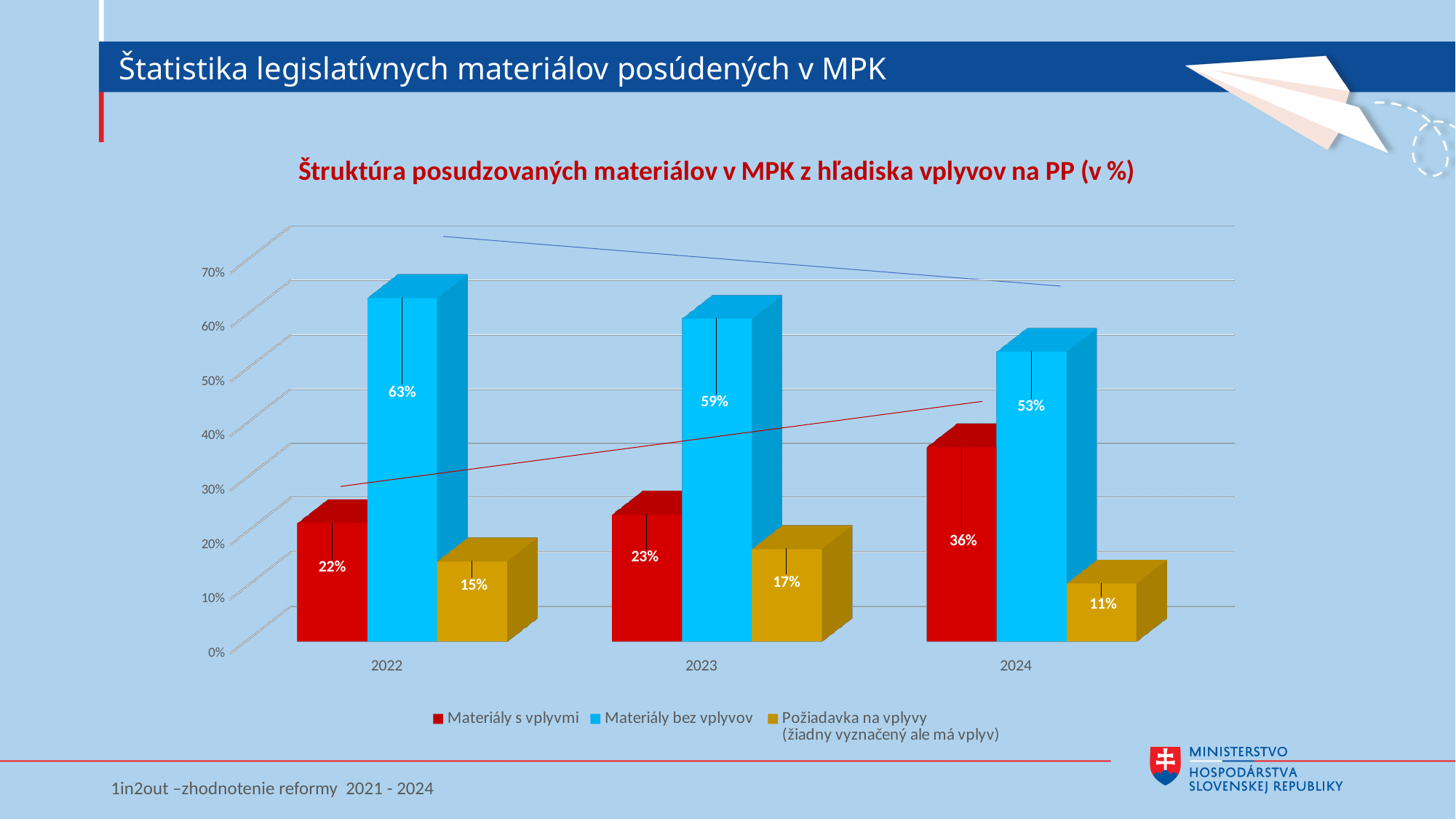
How many years are shown on the x axis? 3 What is the title of the chart? Štruktúra posudzovaných materiálov v MPK z hľadiska vplyvov na PP (v %) Which is larger in 2023: Materiály s vplyvmi or Požiadavka na vplyvy (žiadny vyznačený ale má vplyv)? Materiály s vplyvmi How many series does the legend list? 3 What is the value for Materiály s vplyvmi in 2024? 36% Does the value for Materiály s vplyvmi rise or fall from 2022 to 2024? rise What is the difference between Materiály bez vplyvov and Materiály s vplyvmi in 2024? 17% What is the value for Požiadavka na vplyvy (žiadny vyznačený ale má vplyv) in 2023? 17% In which year is the value for Materiály bez vplyvov the highest? 2022 What is the value for Materiály bez vplyvov in 2022? 63% What kind of chart is shown on the slide? bar chart In which year is the value for Požiadavka na vplyvy (žiadny vyznačený ale má vplyv) the lowest? 2024